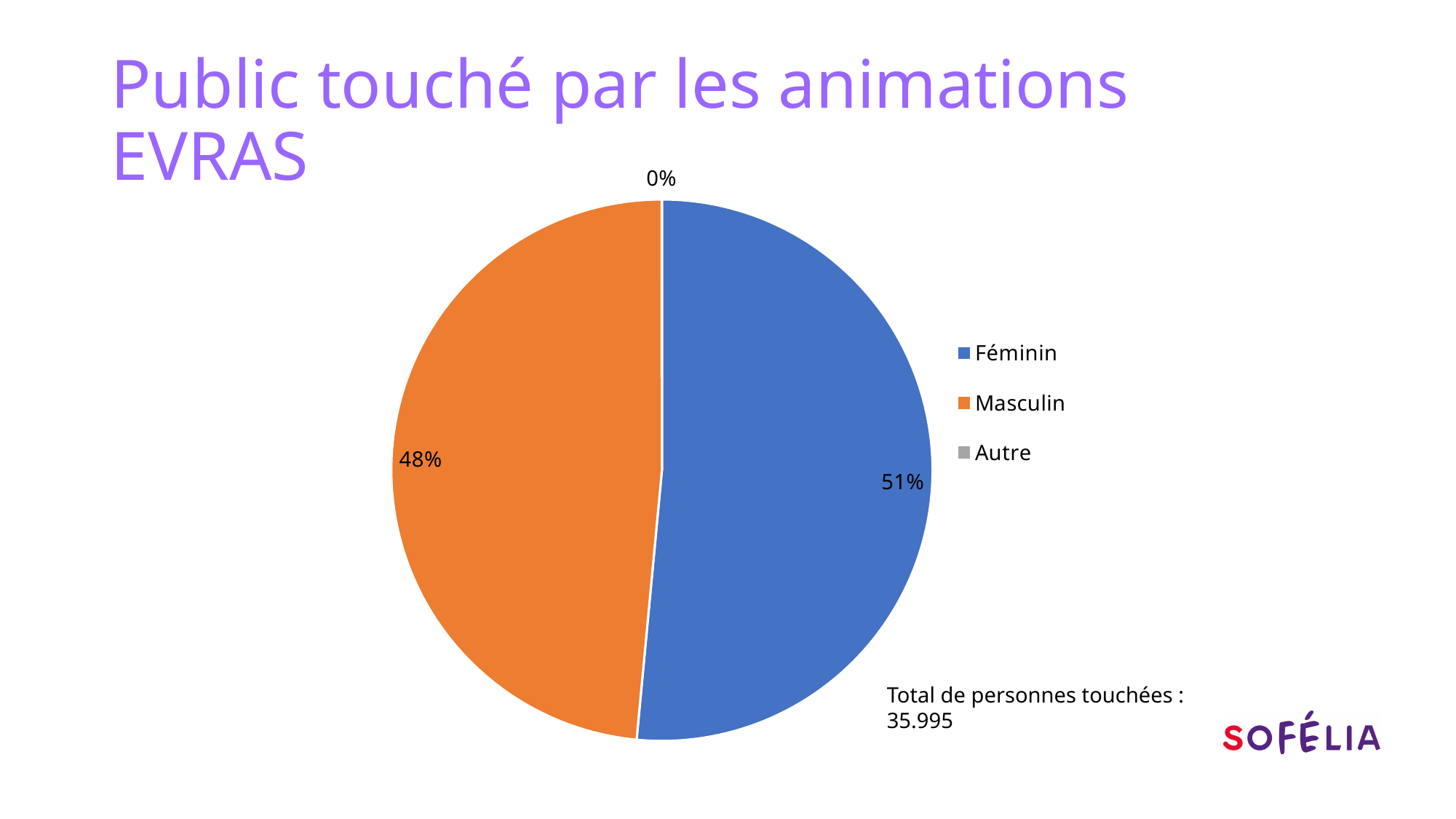
Which category has the largest slice of the pie? Féminin What is the difference in percentage points between the Féminin and Masculin slices? 3% What is the title of the slide? Public touché par les animations EVRAS What is the total number of people reached, as stated on the slide? 35.995 What kind of chart is shown on the slide? Pie chart Which slice is larger, Féminin or Masculin? Féminin What share of the pie does Féminin represent? 51% How many categories does the legend list? 3 What share of the pie does Masculin represent? 48% What share of the pie does Autre represent? 0% What colour is the Masculin slice? Orange Which category has the smallest slice of the pie? Autre